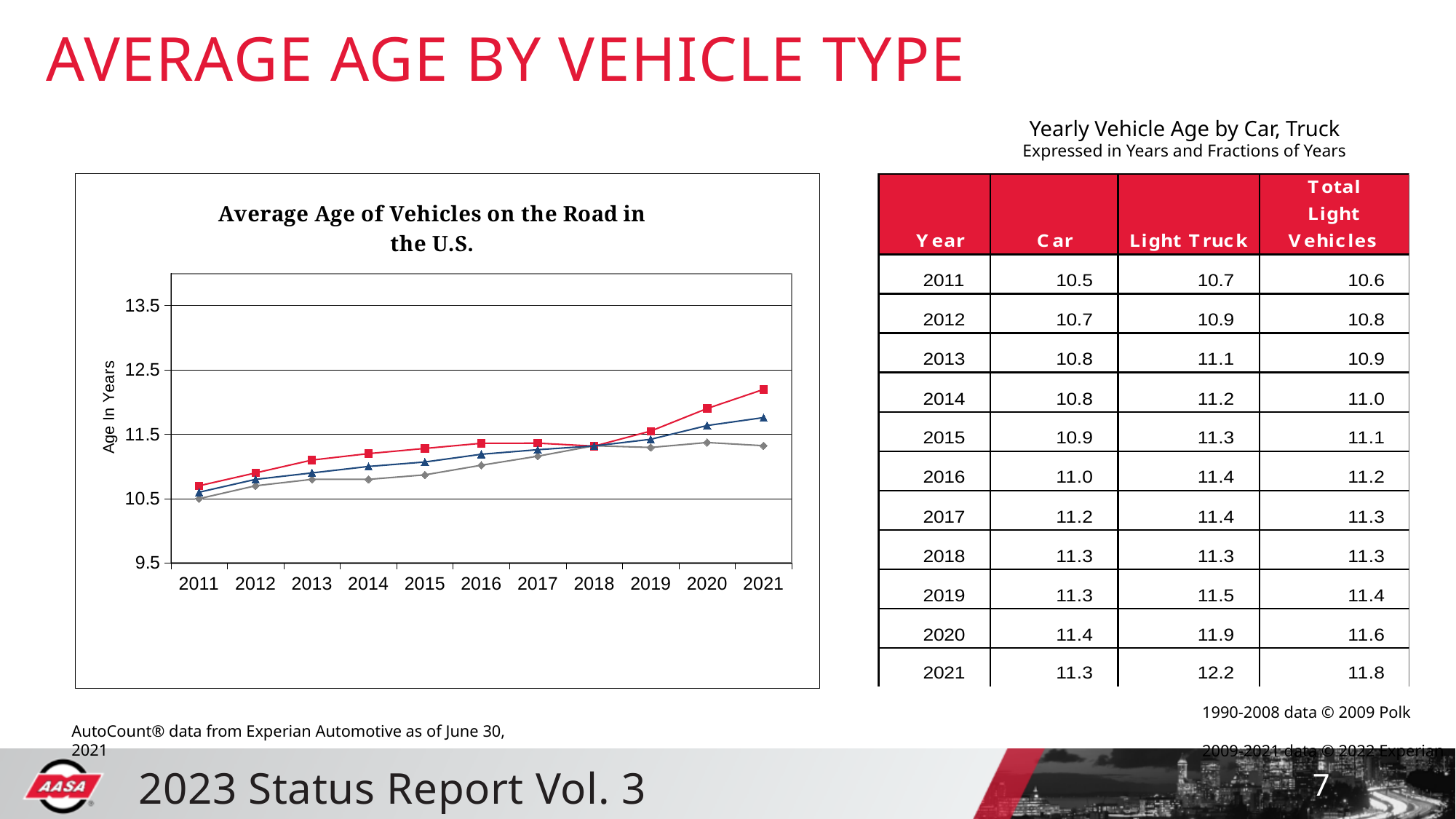
Which line is highest at 2021 on the chart? the red line Is the value of the red line at 2011 greater or less than 11.5? less Does the red line generally rise or fall from 2011 to 2021? rise How many lines are plotted on the chart? 3 What is the title of the chart? Average Age of Vehicles on the Road in the U.S. Is the value of the red line at 2021 greater or less than 11.5? greater What kind of chart is shown on the slide? line chart Is the value of the blue line at 2021 greater or less than 11.5? greater How many years are plotted along the x axis of the chart? 11 Which line is lowest at 2021 on the chart? the grey line What is the label on the chart's vertical axis? Age In Years